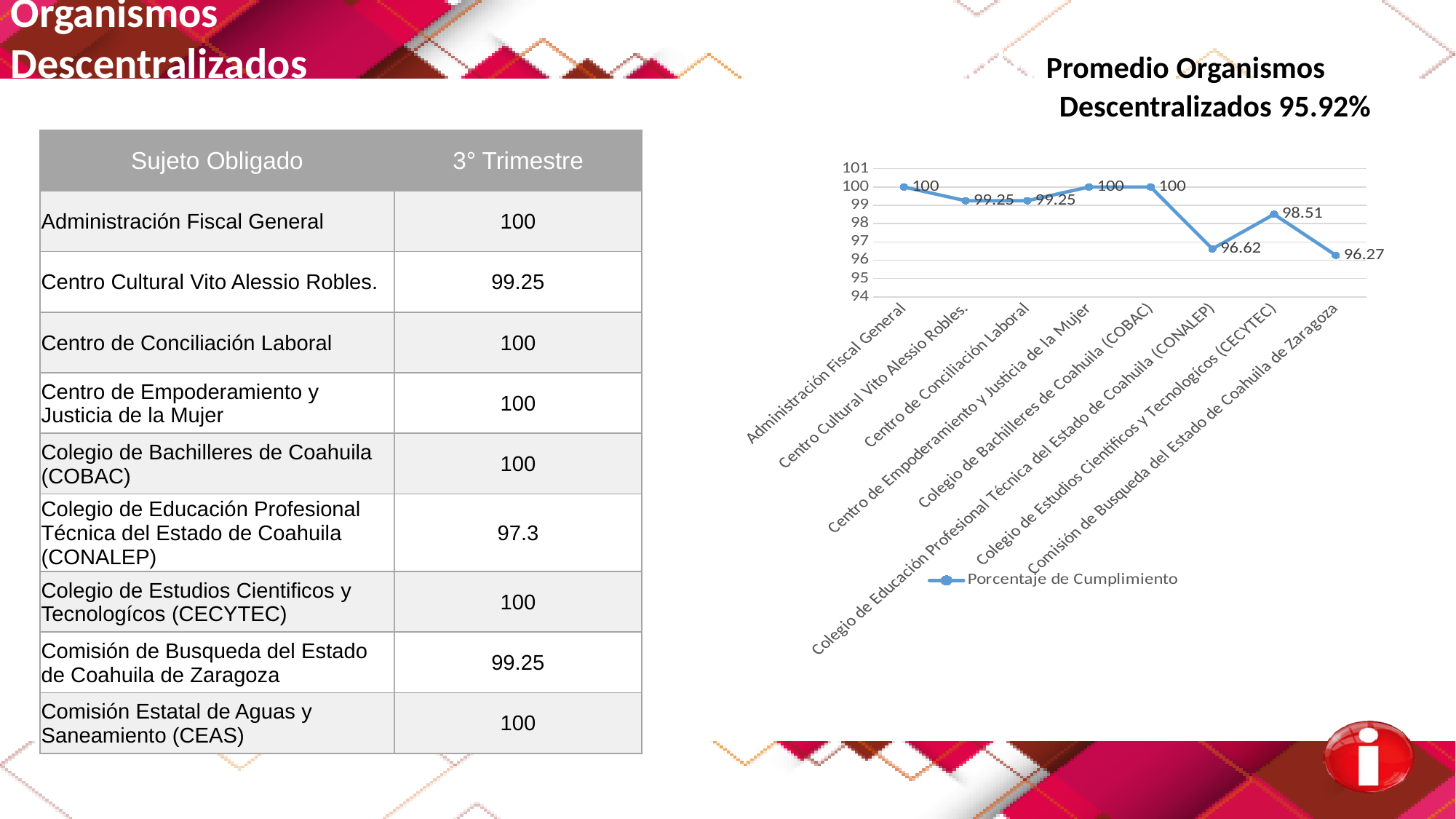
What is the value plotted for Centro Cultural Vito Alessio Robles in the chart? 99.25 What is the value plotted for Colegio de Educación Profesional Técnica del Estado de Coahuila (CONALEP) in the chart? 96.62 How many categories are plotted in the chart? 8 Which has a higher value in the chart, CECYTEC or CONALEP? CECYTEC What type of chart is shown on the slide? line chart Which category has the lowest value in the chart? Comisión de Busqueda del Estado de Coahuila de Zaragoza What is the value plotted for Colegio de Estudios Científicos y Tecnológicos (CECYTEC) in the chart? 98.51 How many series does the chart legend list? 1 What is the difference between the values for CECYTEC and CONALEP in the chart? 1.89 What is the name of the series shown in the chart legend? Porcentaje de Cumplimiento What is the value plotted for Comisión de Busqueda del Estado de Coahuila de Zaragoza in the chart? 96.27 Is the value for CONALEP in the chart greater or less than 97? less